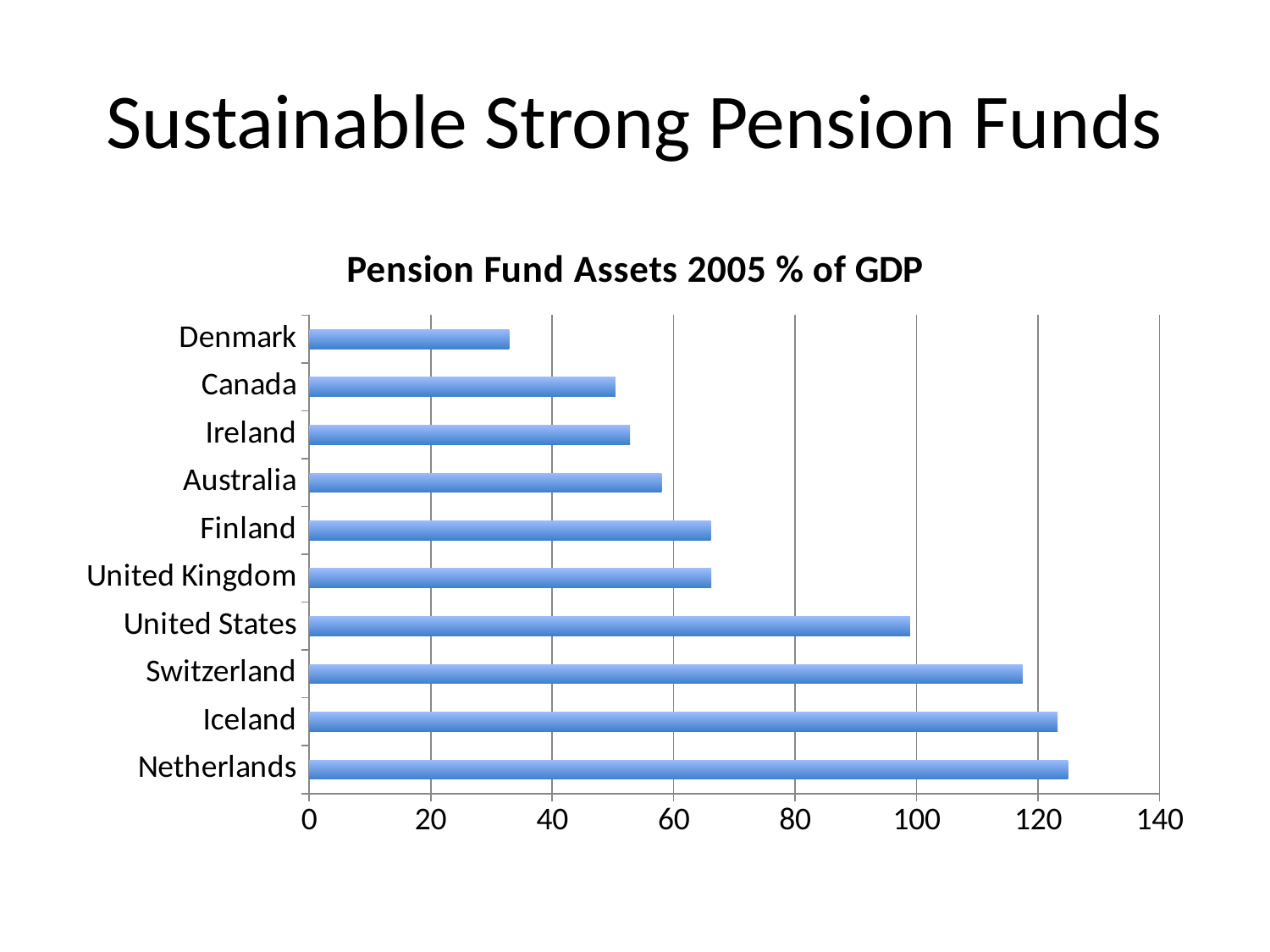
Is the value for Canada greater or less than 40? greater Is the value for Denmark greater or less than 40? less Is the value for Finland greater or less than 60? greater How many countries are shown in the chart? 10 What is the title of the chart? Pension Fund Assets 2005 % of GDP Which has the larger value, Denmark or Canada? Canada Which country has the lowest pension fund assets as % of GDP? Denmark Which has the larger value, the United States or Switzerland? Switzerland What kind of chart is shown on the slide? bar chart